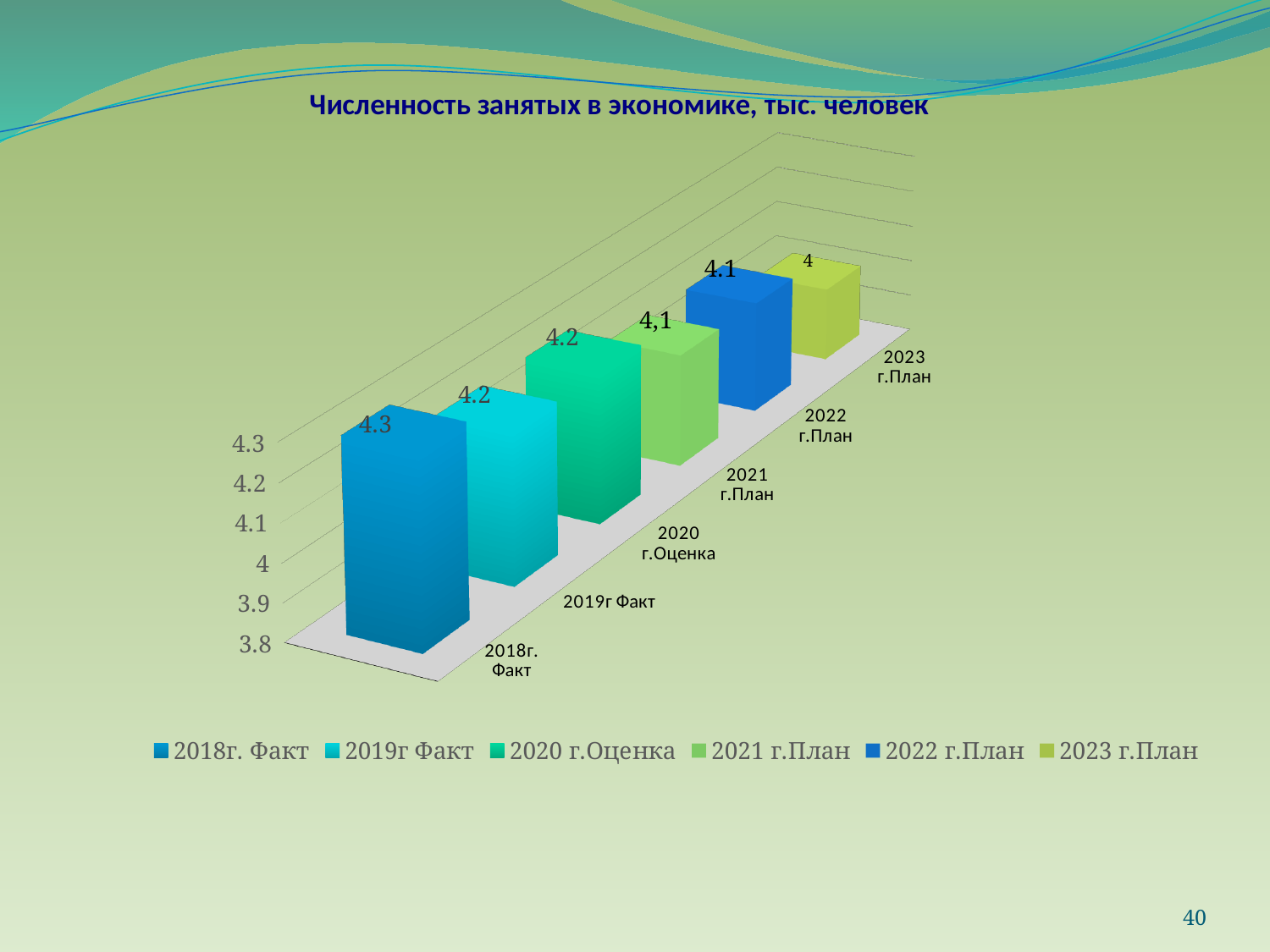
What is the value for 2023 г.План? 4 How many entries does the legend list? 6 Do the values rise or fall from 2018г. Факт to 2023 г.План? fall Which category has the highest value? 2018г. Факт What is the difference between the values for 2018г. Факт and 2023 г.План? 0.3 Which is larger, the value for 2019г Факт or the value for 2022 г.План? 2019г Факт Which category has the lowest value? 2023 г.План What is the value for 2018г. Факт? 4.3 What kind of chart is shown on the slide? bar chart What is the value for 2021 г.План? 4,1 How many bars are plotted on the chart? 6 What is the value for 2020 г.Оценка? 4.2